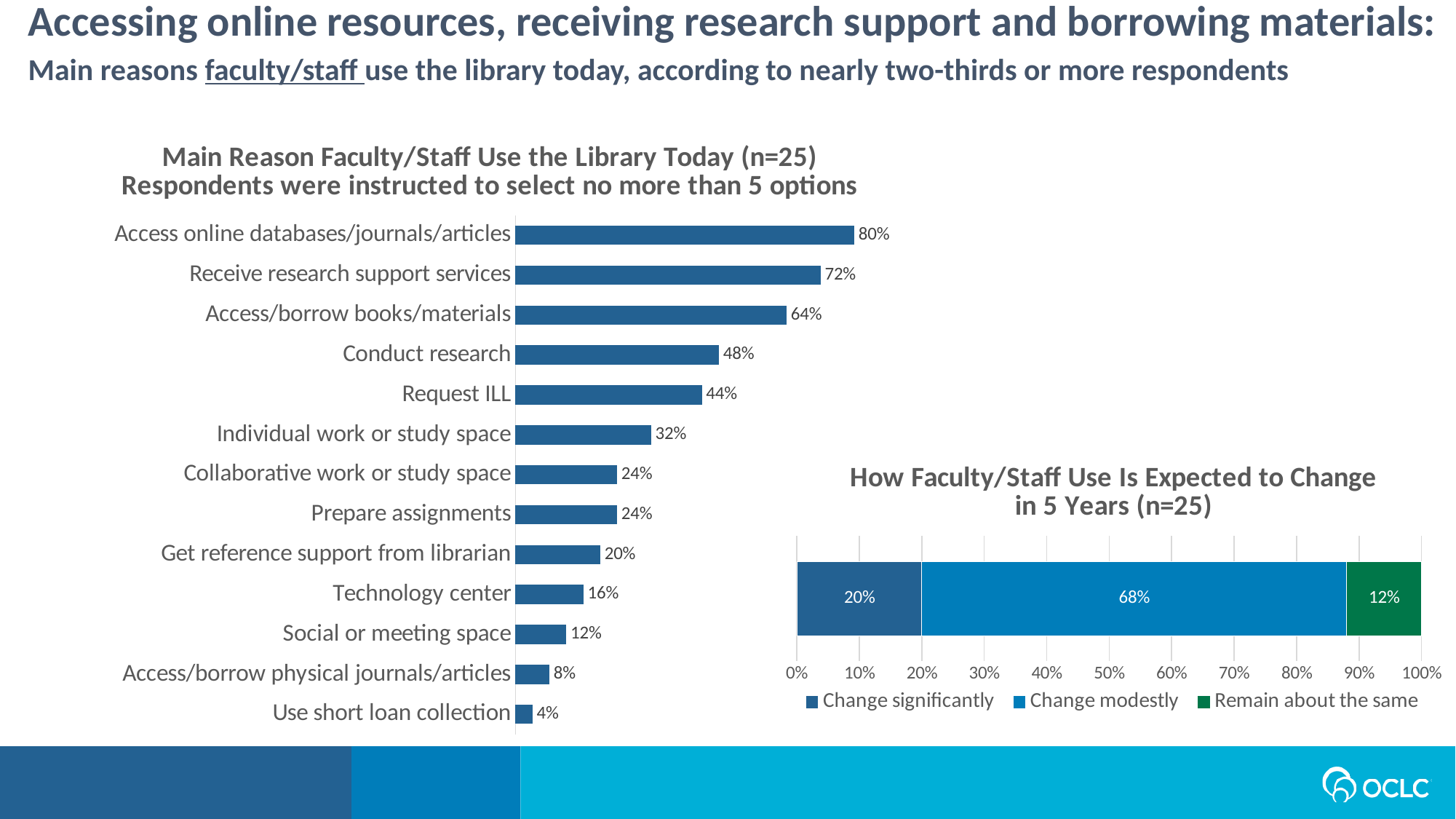
How many categories are shown in the 'Main Reason Faculty/Staff Use the Library Today' chart? 13 In the 'Main Reason Faculty/Staff Use the Library Today' chart, which category has the lowest value? Use short loan collection In the 'Main Reason Faculty/Staff Use the Library Today' chart, which category has the highest value? Access online databases/journals/articles In the 'How Faculty/Staff Use Is Expected to Change in 5 Years' chart, what is the total of the stacked bar? 100% How many series does the legend list in the 'How Faculty/Staff Use Is Expected to Change in 5 Years' chart? 3 In the 'Main Reason Faculty/Staff Use the Library Today' chart, which is larger: 'Conduct research' or 'Individual work or study space'? Conduct research In the 'Main Reason Faculty/Staff Use the Library Today' chart, what percentage is shown for 'Request ILL'? 44% In the 'Main Reason Faculty/Staff Use the Library Today' chart, what percentage is shown for 'Receive research support services'? 72% In the 'Main Reason Faculty/Staff Use the Library Today' chart, what is the difference between 'Access online databases/journals/articles' and 'Access/borrow books/materials'? 16% In the 'How Faculty/Staff Use Is Expected to Change in 5 Years' chart, what percentage is shown for 'Change modestly'? 68% What kind of chart is the 'Main Reason Faculty/Staff Use the Library Today' chart? Bar chart In the 'How Faculty/Staff Use Is Expected to Change in 5 Years' chart, what percentage is shown for 'Remain about the same'? 12%